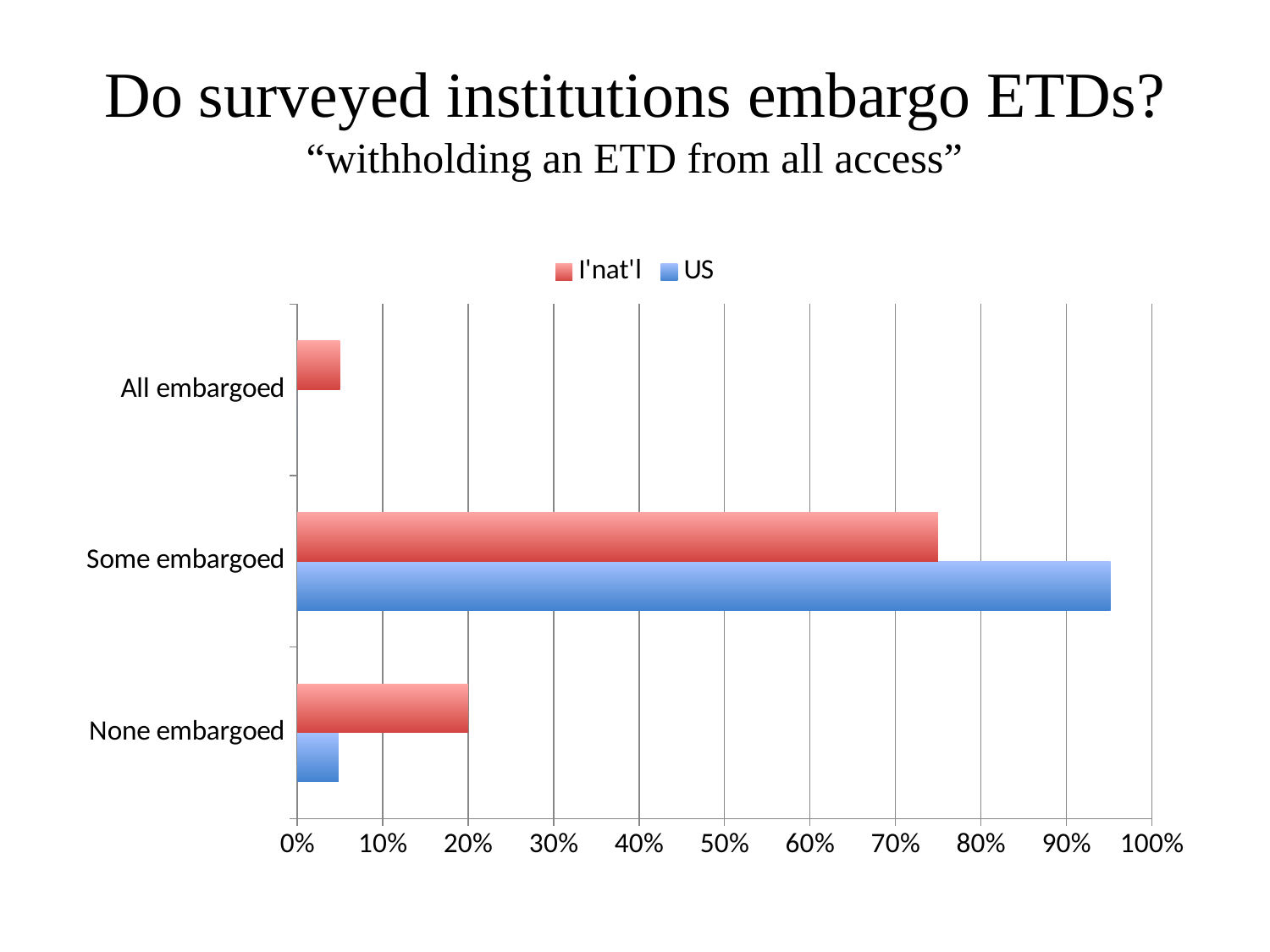
What are the two series named in the legend? I'nat'l and US For None embargoed, which series has the larger value, I'nat'l or US? I'nat'l Is the US value for Some embargoed greater or less than 90%? greater Which category has the highest value for the US series? Some embargoed Which category has the highest value for the I'nat'l series? Some embargoed How many categories are shown on the vertical axis? 3 For Some embargoed, which series has the larger value, I'nat'l or US? US Is the I'nat'l value for Some embargoed greater or less than 70%? greater What kind of chart is shown on the slide? bar chart How many series does the legend list? 2 Is the I'nat'l value for All embargoed greater or less than 10%? less Which category has the lowest value for the I'nat'l series? All embargoed